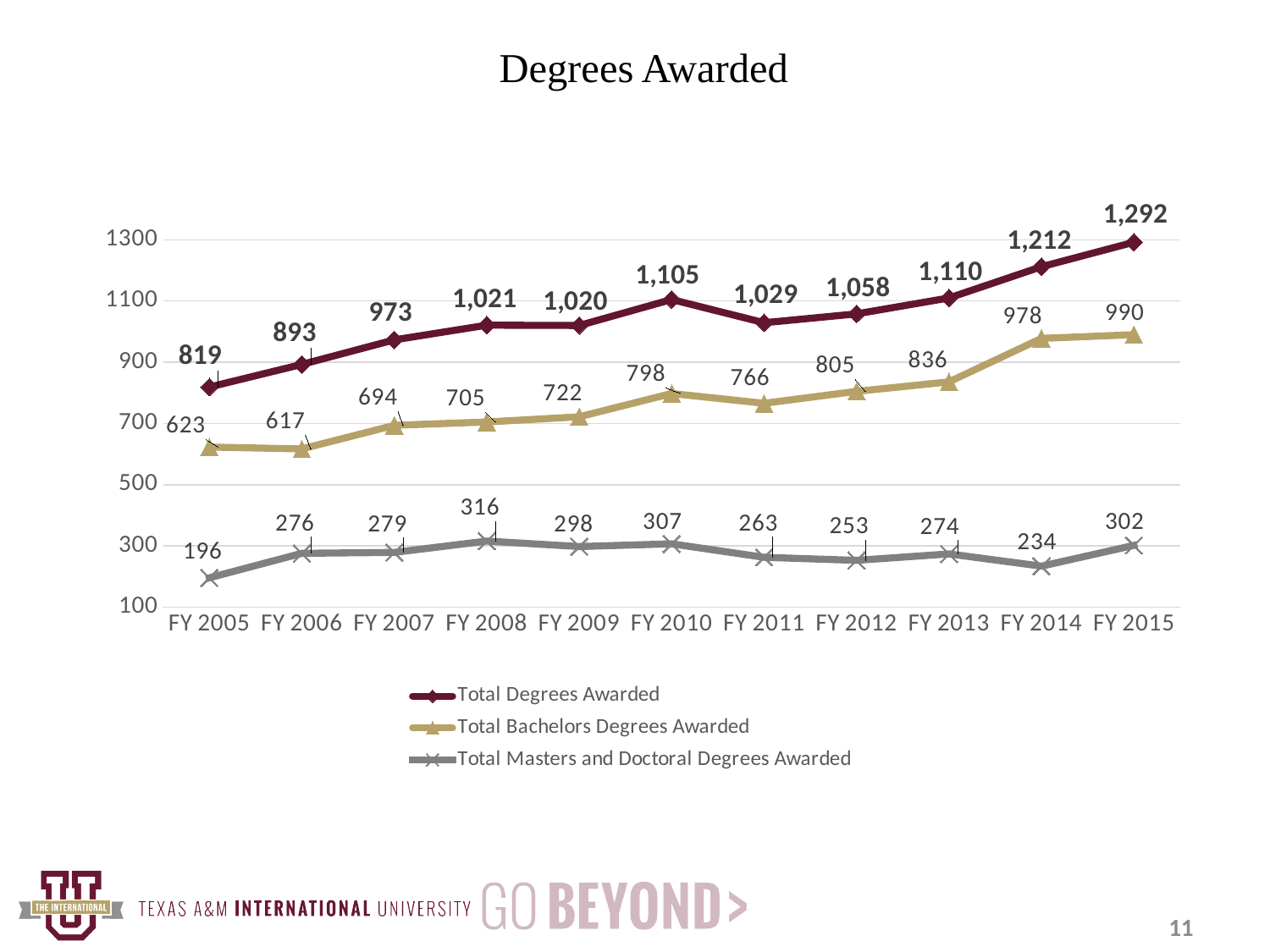
Does Total Bachelors Degrees Awarded rise or fall from FY 2012 to FY 2015? Rise What is the title of the chart? Degrees Awarded In which fiscal year is Total Degrees Awarded highest? FY 2015 What kind of chart is this? Line chart In which fiscal year is Total Masters and Doctoral Degrees Awarded lowest? FY 2005 What is the difference between Total Degrees Awarded in FY 2015 and FY 2005? 473 What is the value for Total Degrees Awarded in FY 2010? 1,105 What is the value for Total Masters and Doctoral Degrees Awarded in FY 2008? 316 What is the value for Total Bachelors Degrees Awarded in FY 2014? 978 Which is larger: Total Bachelors Degrees Awarded in FY 2011 or in FY 2012? FY 2012 How many fiscal years are shown on the x axis? 11 How many series does the legend list? 3